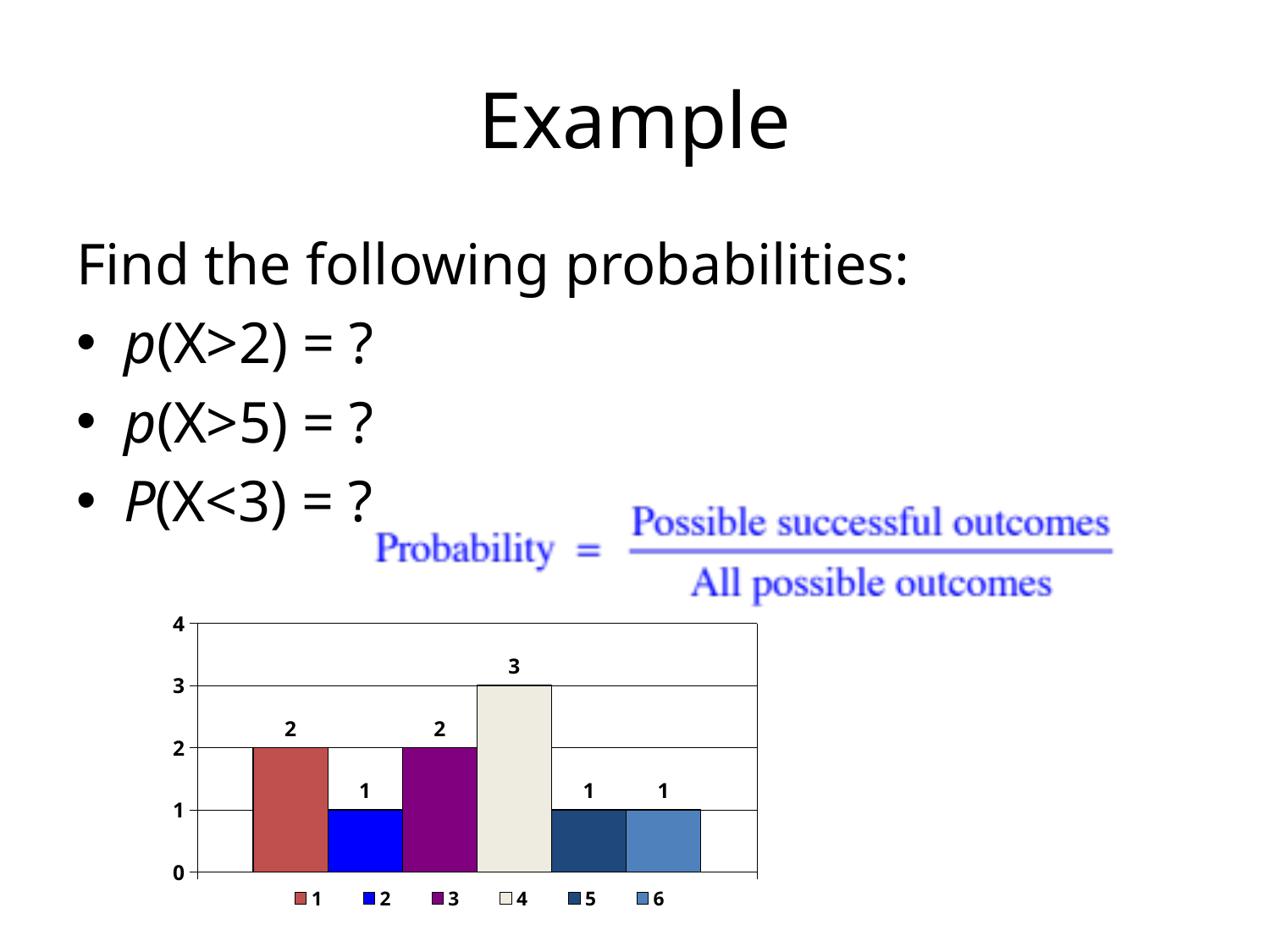
What is the difference between the value for series 4 and the value for series 2? 2 What is the value of the bar for series 4? 3 What is the highest value shown on the vertical axis? 4 What kind of chart is shown on the slide? bar chart Which is larger, the value for series 3 or the value for series 6? series 3 What is the value of the bar for series 5? 1 What colour is the bar for series 2? blue What is the value of the bar for series 1? 2 What is the total of all six bar values? 10 How many bars are plotted in the chart? 6 Which series has the highest bar? 4 How many series does the legend list? 6